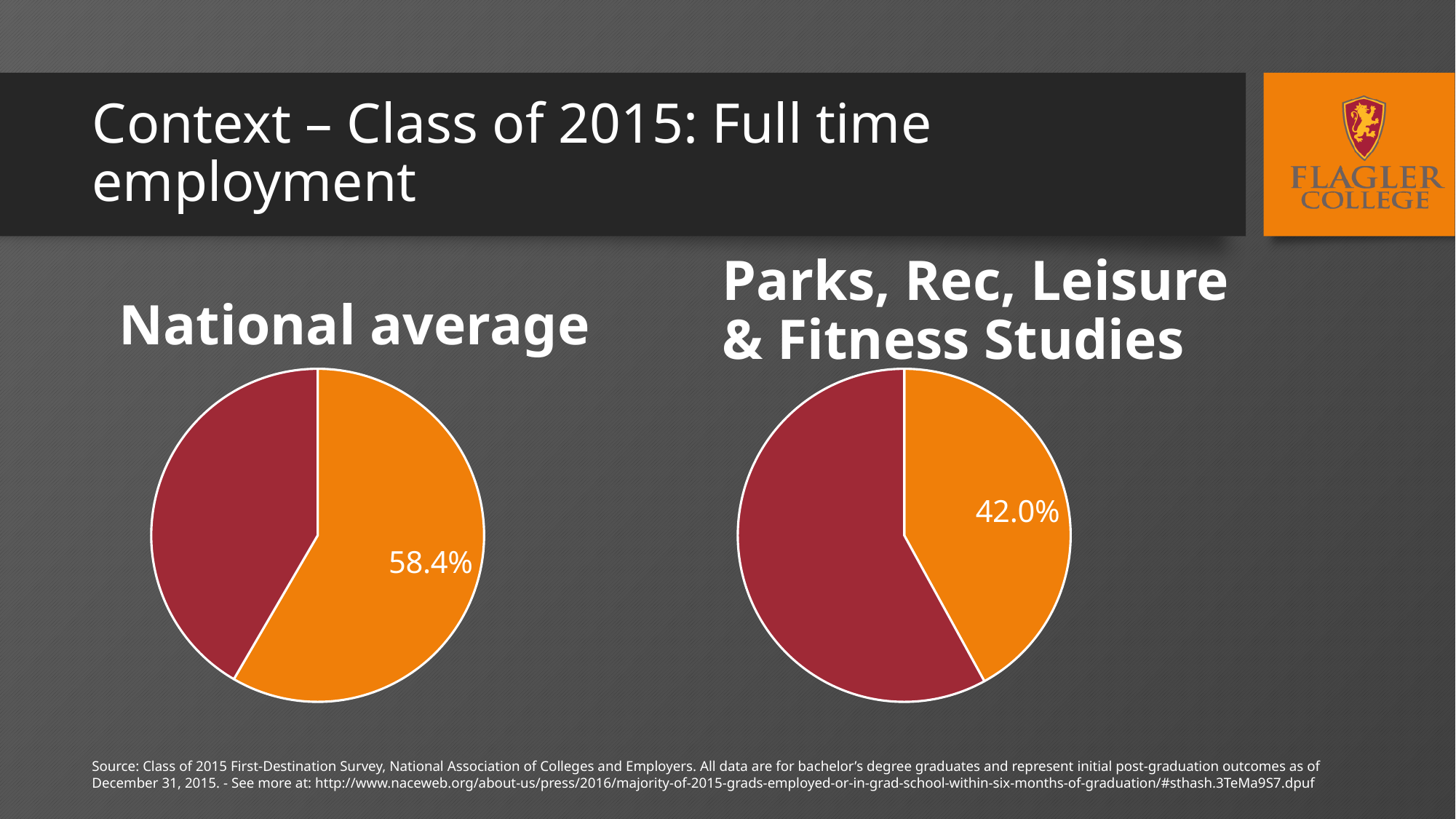
In the "National average" pie chart, is the orange slice greater or less than 50% of the pie? greater In the "Parks, Rec, Leisure & Fitness Studies" pie chart, is the orange slice greater or less than 50% of the pie? less What kind of chart is the "National average" chart? pie chart What is the title of the pie chart on the left side of the slide? National average In the "National average" pie chart, what value is printed on the orange slice? 58.4% What is the difference between the labelled value in the "National average" chart (58.4%) and the labelled value in the "Parks, Rec, Leisure & Fitness Studies" chart (42.0%)? 16.4 percentage points How many slices does the "National average" pie chart have? 2 In the "Parks, Rec, Leisure & Fitness Studies" pie chart, what value is printed on the orange slice? 42.0% In the "Parks, Rec, Leisure & Fitness Studies" pie chart, is the red slice greater or less than 50% of the pie? greater How many slices does the "Parks, Rec, Leisure & Fitness Studies" pie chart have? 2 What colour is the slice labelled 58.4% in the "National average" pie chart? orange Which chart has the larger labelled orange slice, "National average" or "Parks, Rec, Leisure & Fitness Studies"? National average